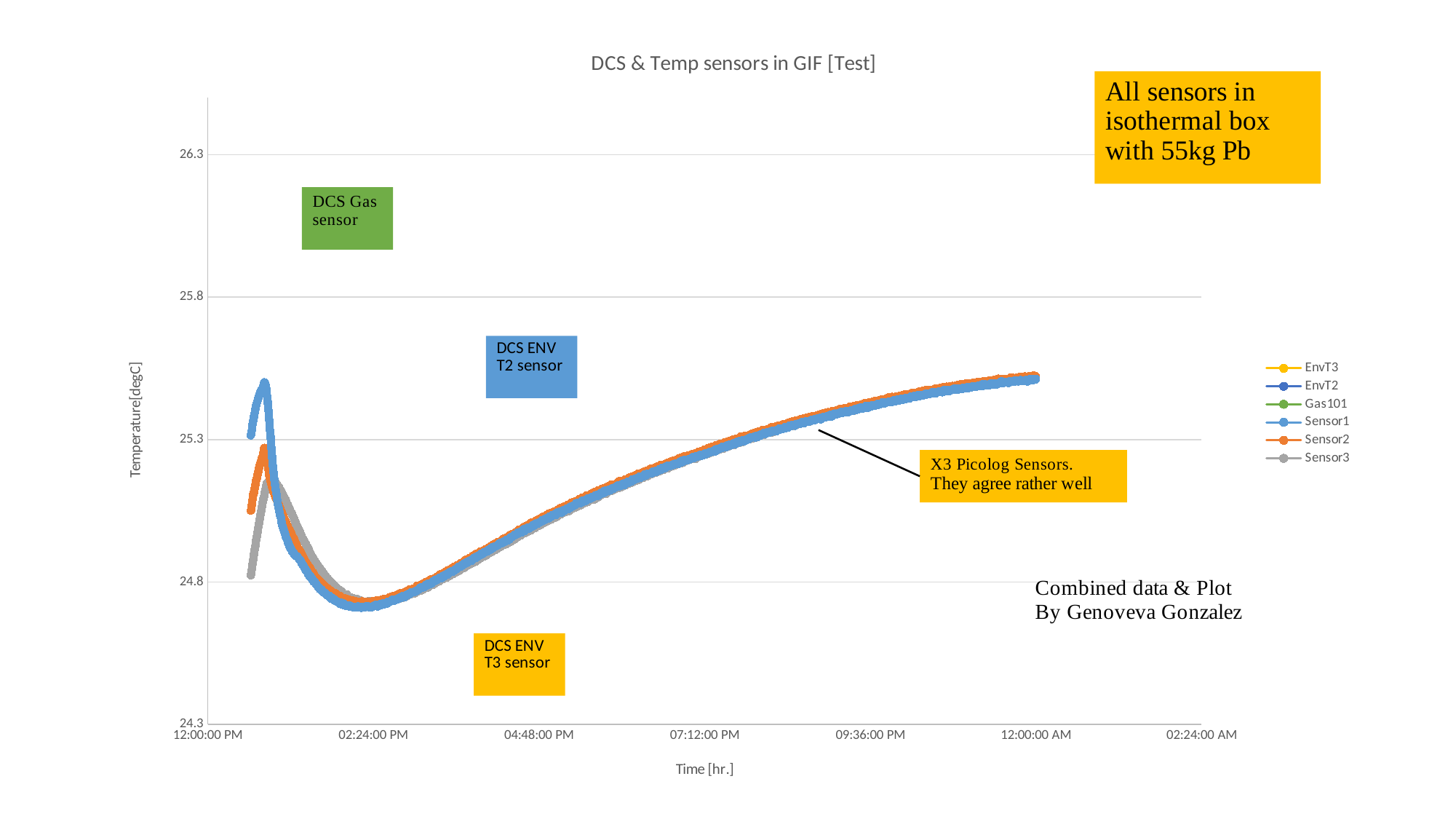
Is the peak value of Sensor1 near the start of the recording greater or less than 25.3? greater What is the title of the chart? DCS & Temp sensors in GIF [Test] Is the peak of Sensor1 near the start higher or lower than the peak of Sensor3 near the start? higher Is the lowest value reached by the Sensor1 curve (around 02:24:00 PM) greater or less than 24.8? less How many series does the chart legend list? 6 Do the sensor values rise or fall between 02:24:00 PM and 12:00:00 AM? rise What kind of chart is shown on the slide? line chart Which plotted series has the lowest starting value at the beginning of the recording? Sensor3 Is the value of Sensor2 at 12:00:00 AM greater or less than 25.8? less Which plotted series reaches the highest peak shortly after 12:00:00 PM? Sensor1 What is the label of the vertical axis? Temperature[degC]